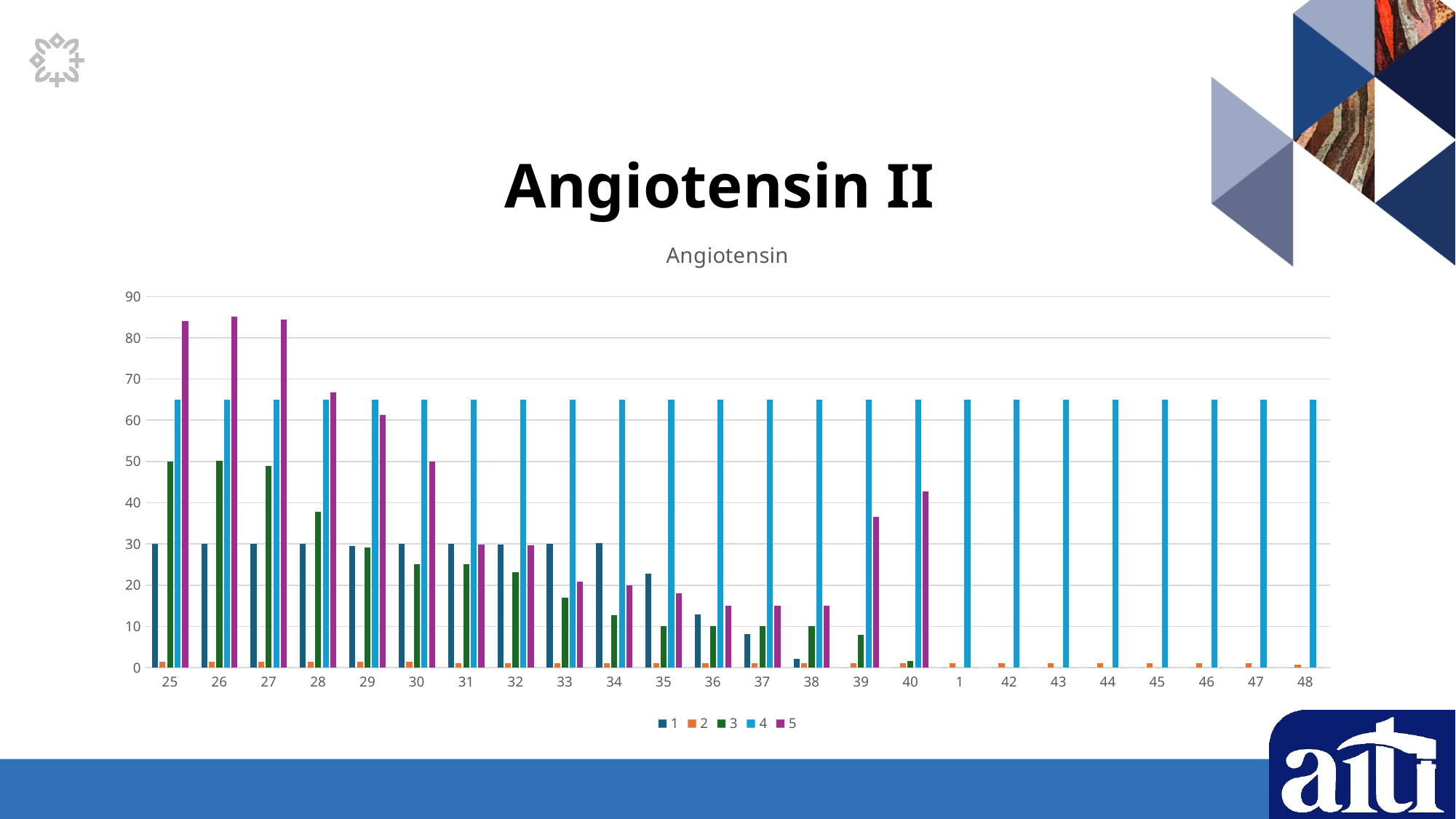
What kind of chart is shown on the slide? bar chart Which series has the lowest bar at category 25? 2 At category 29, which is larger: the value for series 4 or series 5? series 4 How many series does the legend list? 5 Is the value for series 3 at category 33 greater or less than 20? less Is the value for series 4 at category 48 greater or less than 60? greater Do the values for series 3 generally rise or fall from category 25 to category 39? fall Is the value for series 5 at category 40 greater or less than 50? less What is the title of the chart? Angiotensin Which series has the highest bar at category 26? 5 How many categories are shown on the x axis? 24